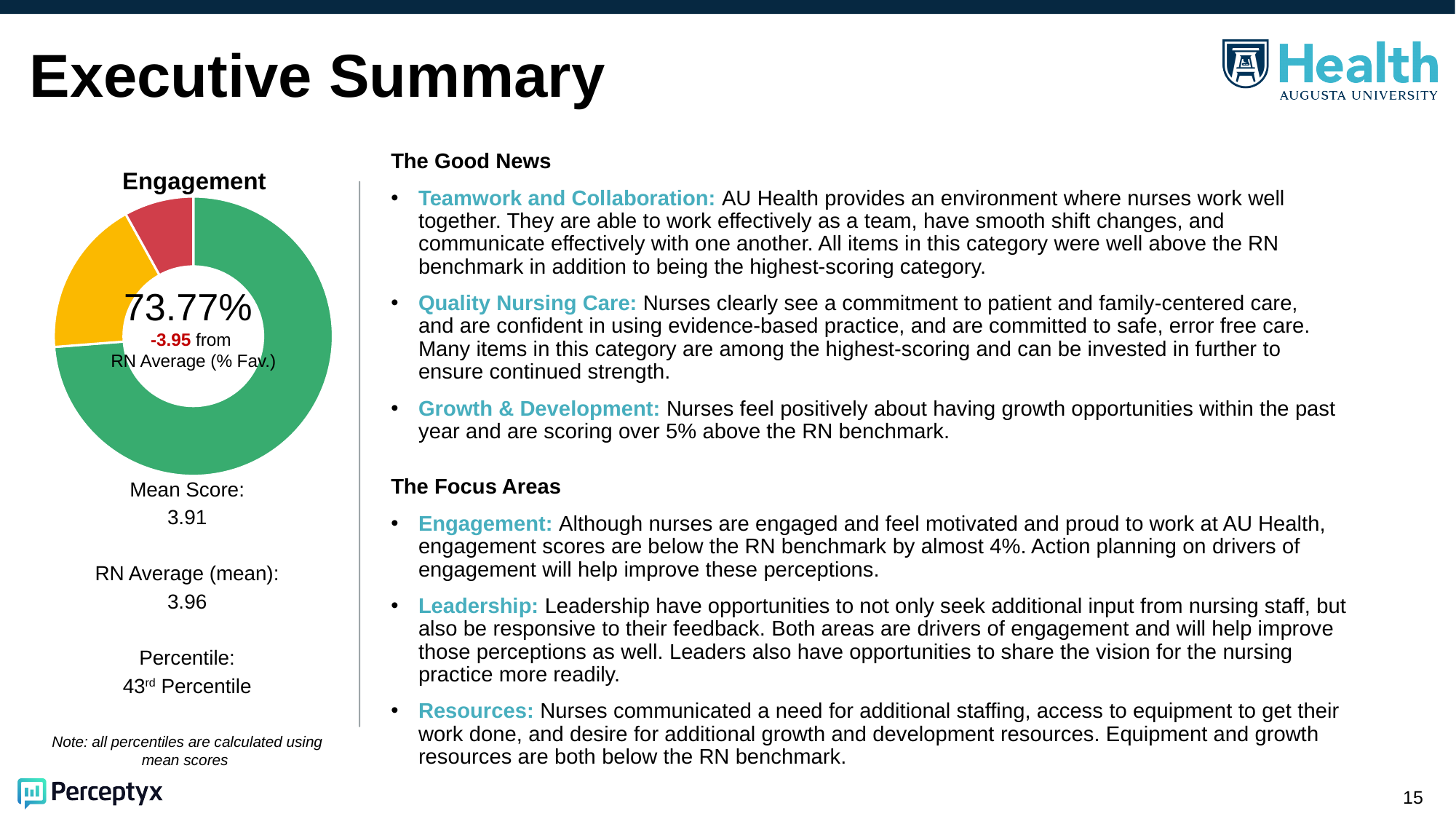
According to the Engagement chart, how far is the score from the RN Average (% Fav.)? -3.95 How many slices does the Engagement donut chart have? 3 What Mean Score is listed below the Engagement chart? 3.91 Which colour slice is the largest in the Engagement donut chart? Green What RN Average (mean) is listed below the Engagement chart? 3.96 What is the title of the chart on the left of the slide? Engagement What percentile is listed below the Engagement chart? 43rd Percentile In the Engagement donut chart, is the green slice or the yellow slice larger? Green What percentage is printed in the centre of the Engagement donut chart? 73.77% Which colour slice is the smallest in the Engagement donut chart? Red What kind of chart is shown under the heading "Engagement"? Donut (pie) chart In the Engagement donut chart, is the yellow slice or the red slice larger? Yellow